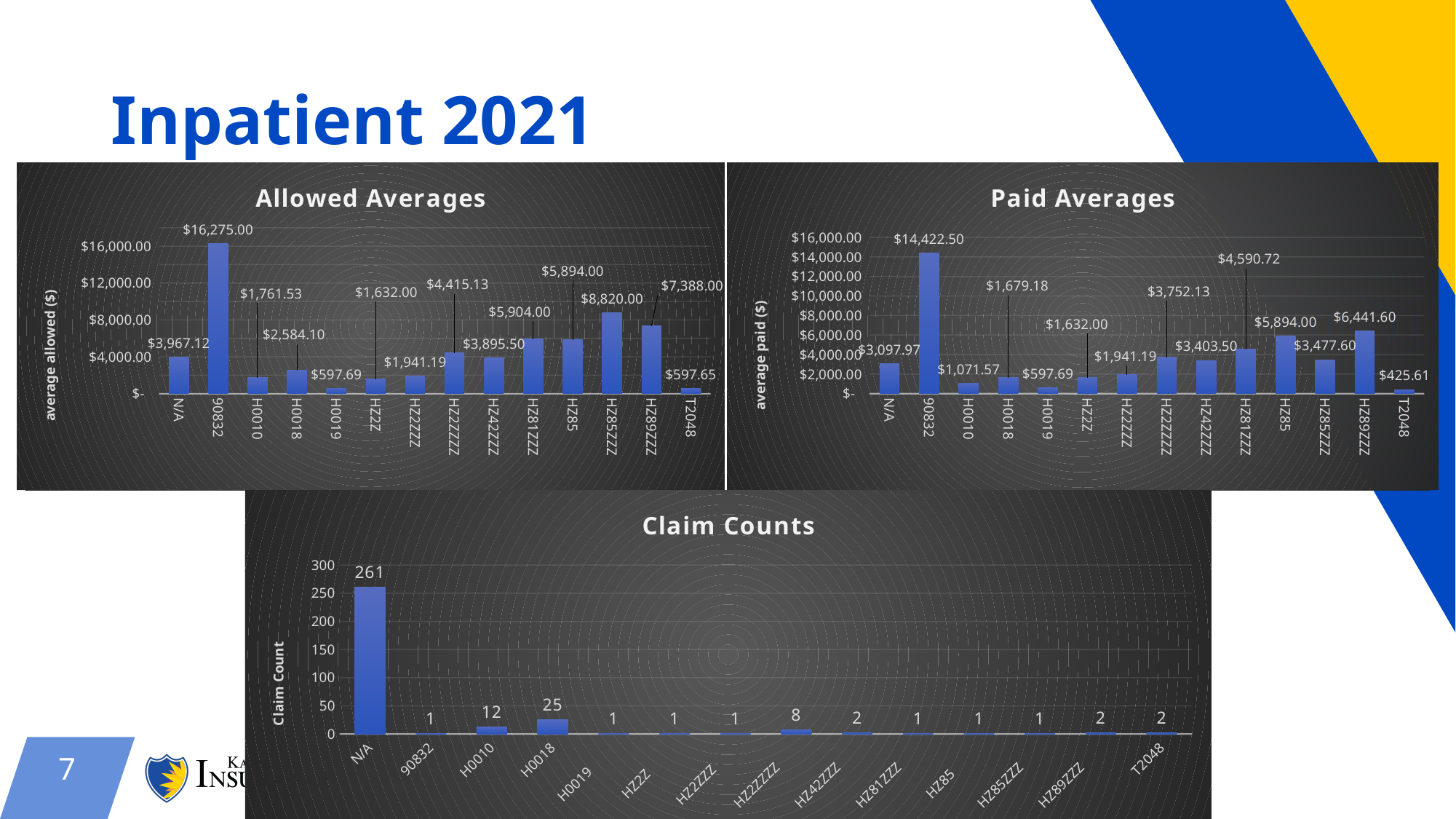
In the Allowed Averages chart, which is larger: the value for HZ85ZZZ or the value for HZ89ZZZ? HZ85ZZZ How many categories are shown on the x axis of the Claim Counts chart? 14 What is the difference between the allowed average and the paid average for 90832? $1,852.50 In the Claim Counts chart, which category has the highest claim count? N/A In the Claim Counts chart, what is the claim count for H0018? 25 In the Allowed Averages chart, what is the average allowed value for 90832? $16,275.00 In the Paid Averages chart, which category has the lowest average paid value? T2048 In the Claim Counts chart, what is the difference between the claim counts for H0018 and H0010? 13 What kind of chart is the Paid Averages chart? Bar chart What is the y-axis title of the Allowed Averages chart? average allowed ($) In the Allowed Averages chart, which category has the highest average allowed value? 90832 In the Paid Averages chart, what is the average paid value for HZ89ZZZ? $6,441.60